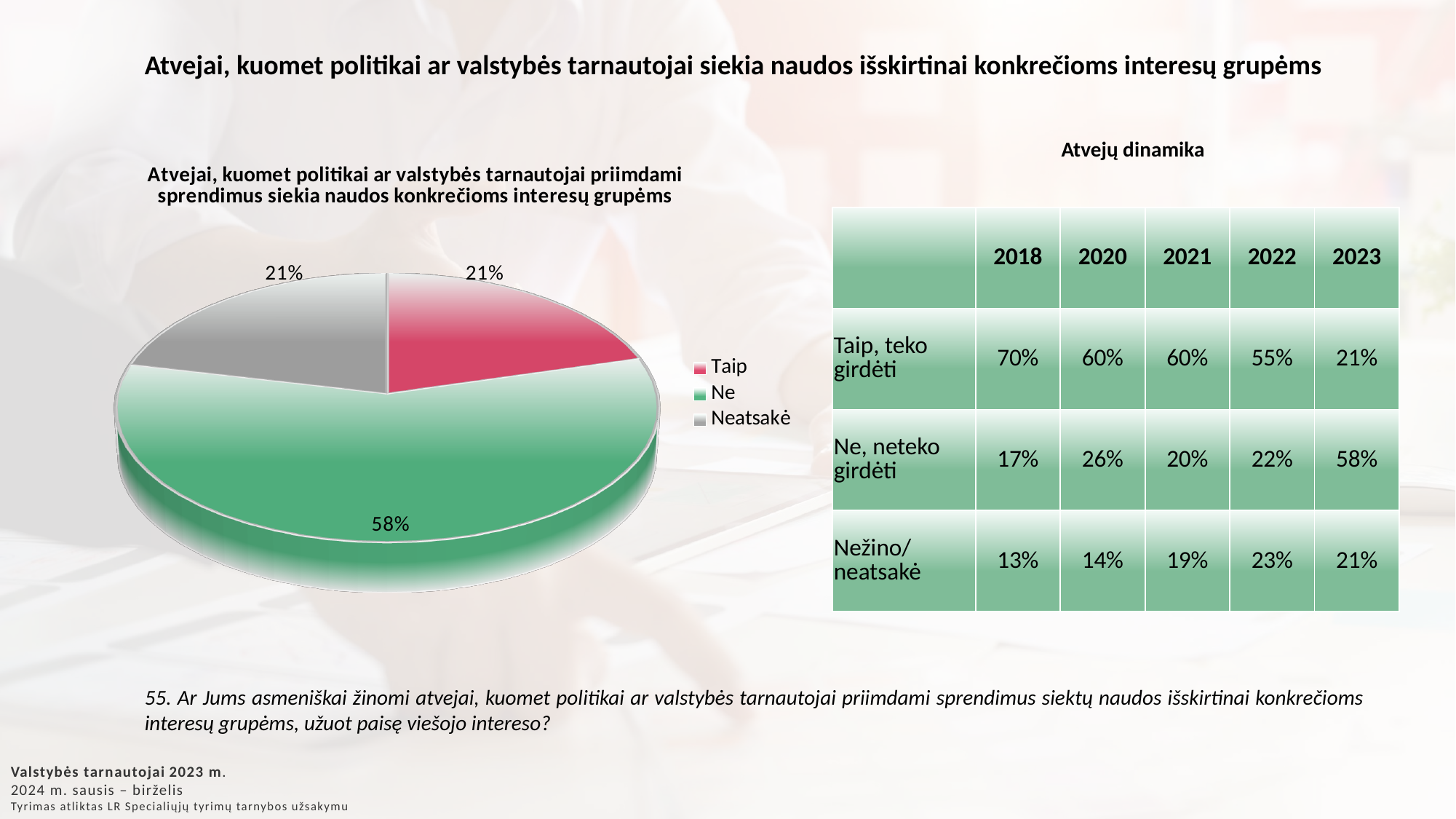
What kind of chart is shown on the left of the slide? Pie chart How many entries does the pie chart's legend list? 3 What colour is the "Taip" slice in the pie chart? Red In the pie chart, what percentage is shown for "Neatsakė"? 21% What share of the pie chart does the "Ne" slice represent? 58% In the pie chart, what percentage is shown for "Taip"? 21% What colour is the "Neatsakė" slice in the pie chart? Grey In the pie chart, which is larger: the slice for "Ne" or the slice for "Neatsakė"? Ne Which category has the largest slice in the pie chart? Ne How many slices does the pie chart have? 3 In the pie chart, what percentage is shown for "Ne"? 58% In the pie chart, what is the difference in percentage points between "Ne" and "Taip"? 37 percentage points